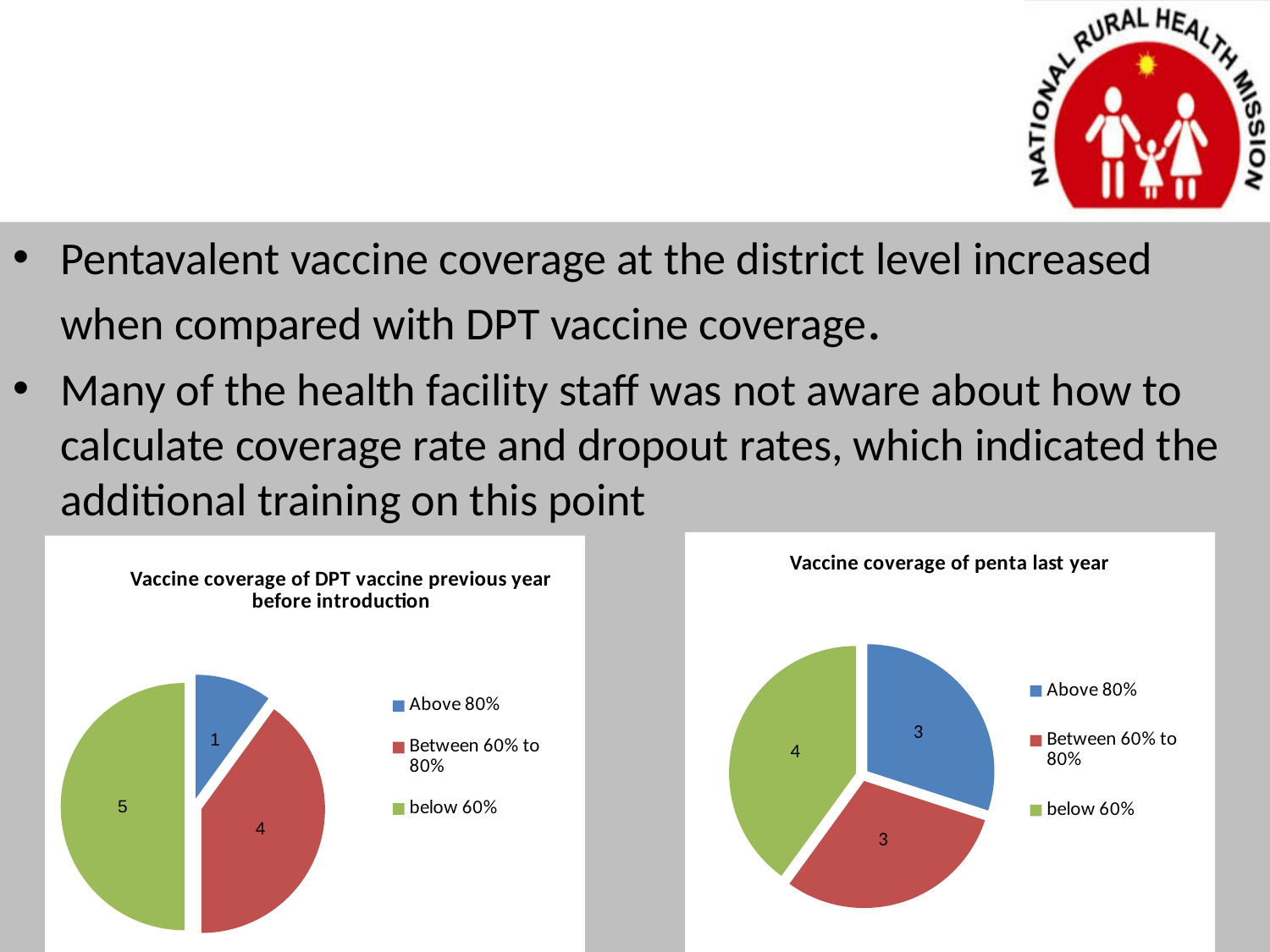
In the chart titled 'Vaccine coverage of DPT vaccine previous year before introduction', what share of the pie does the 'below 60%' slice represent? 50% In the chart titled 'Vaccine coverage of penta last year', what is the value for 'Above 80%'? 3 In the chart titled 'Vaccine coverage of DPT vaccine previous year before introduction', what is the difference between the 'below 60%' value and the 'Above 80%' value? 4 What type of chart is the chart titled 'Vaccine coverage of penta last year'? Pie chart How many categories does the legend list in the chart titled 'Vaccine coverage of penta last year'? 3 In the chart titled 'Vaccine coverage of DPT vaccine previous year before introduction', which category has the smallest slice? Above 80% In the chart titled 'Vaccine coverage of penta last year', what is the value for 'below 60%'? 4 In the chart titled 'Vaccine coverage of DPT vaccine previous year before introduction', what is the value for 'below 60%'? 5 In the chart titled 'Vaccine coverage of DPT vaccine previous year before introduction', what is the value for 'Above 80%'? 1 In the chart titled 'Vaccine coverage of DPT vaccine previous year before introduction', which category has the largest slice? below 60% In the chart titled 'Vaccine coverage of penta last year', which category has the largest slice? below 60% In the chart titled 'Vaccine coverage of penta last year', what share of the pie does the 'below 60%' slice represent? 40%